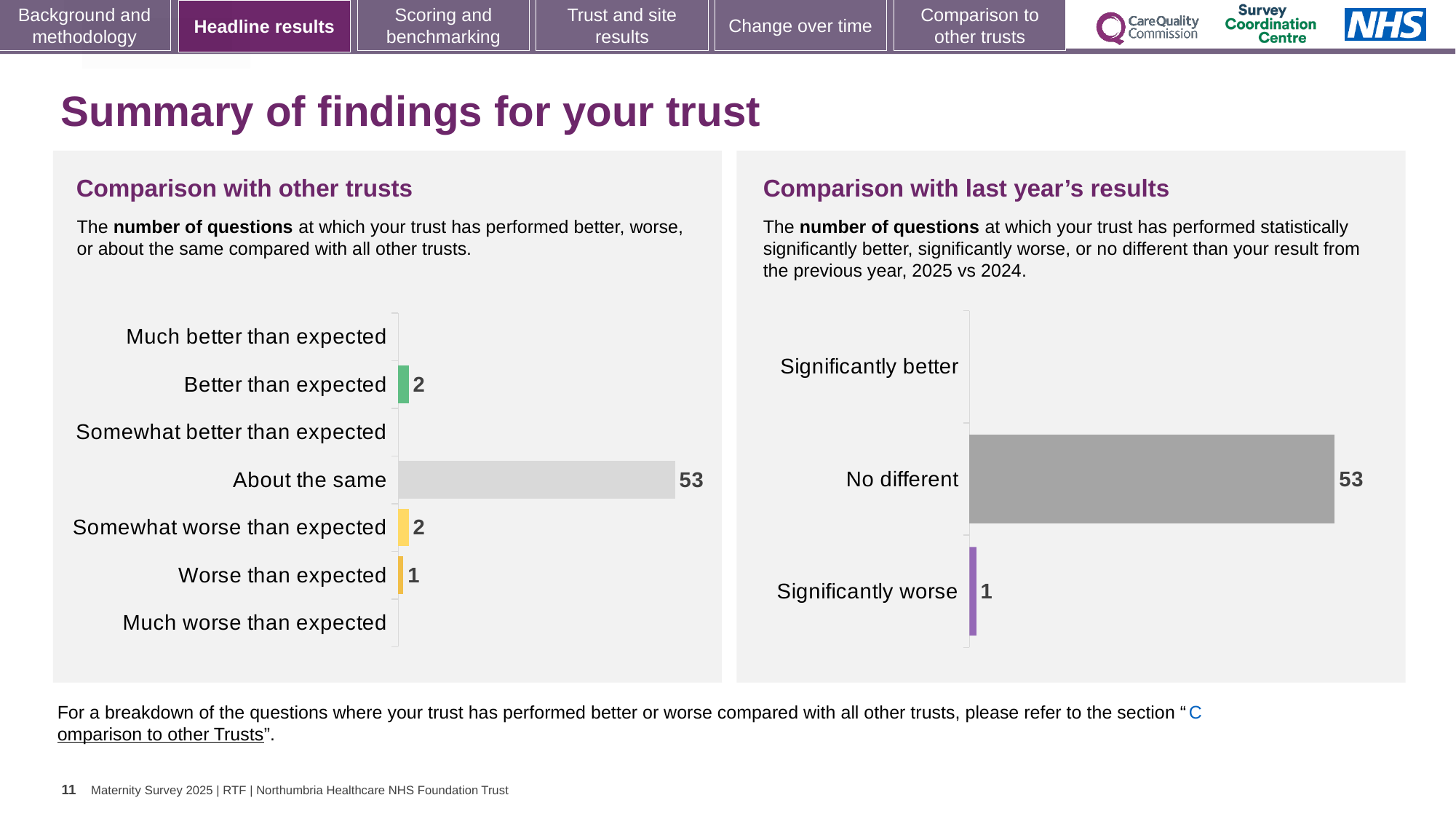
In the 'Comparison with other trusts' chart, how many questions are 'About the same'? 53 In the 'Comparison with last year's results' chart, how many categories are listed on the axis? 3 In the 'Comparison with other trusts' chart, how many questions are 'Better than expected'? 2 In the 'Comparison with last year's results' chart, what is the difference between 'No different' and 'Significantly worse'? 52 In the 'Comparison with other trusts' chart, which is larger: 'Better than expected' or 'Worse than expected'? Better than expected What type of chart is the 'Comparison with last year's results' chart? Bar chart In the 'Comparison with other trusts' chart, how many questions are 'Worse than expected'? 1 In the 'Comparison with last year's results' chart, how many questions are 'No different'? 53 In the 'Comparison with other trusts' chart, what is the difference between 'About the same' and 'Somewhat worse than expected'? 51 In the 'Comparison with last year's results' chart, how many questions are 'Significantly worse'? 1 In the 'Comparison with other trusts' chart, how many categories are listed on the axis? 7 In the 'Comparison with other trusts' chart, which category has the highest value? About the same